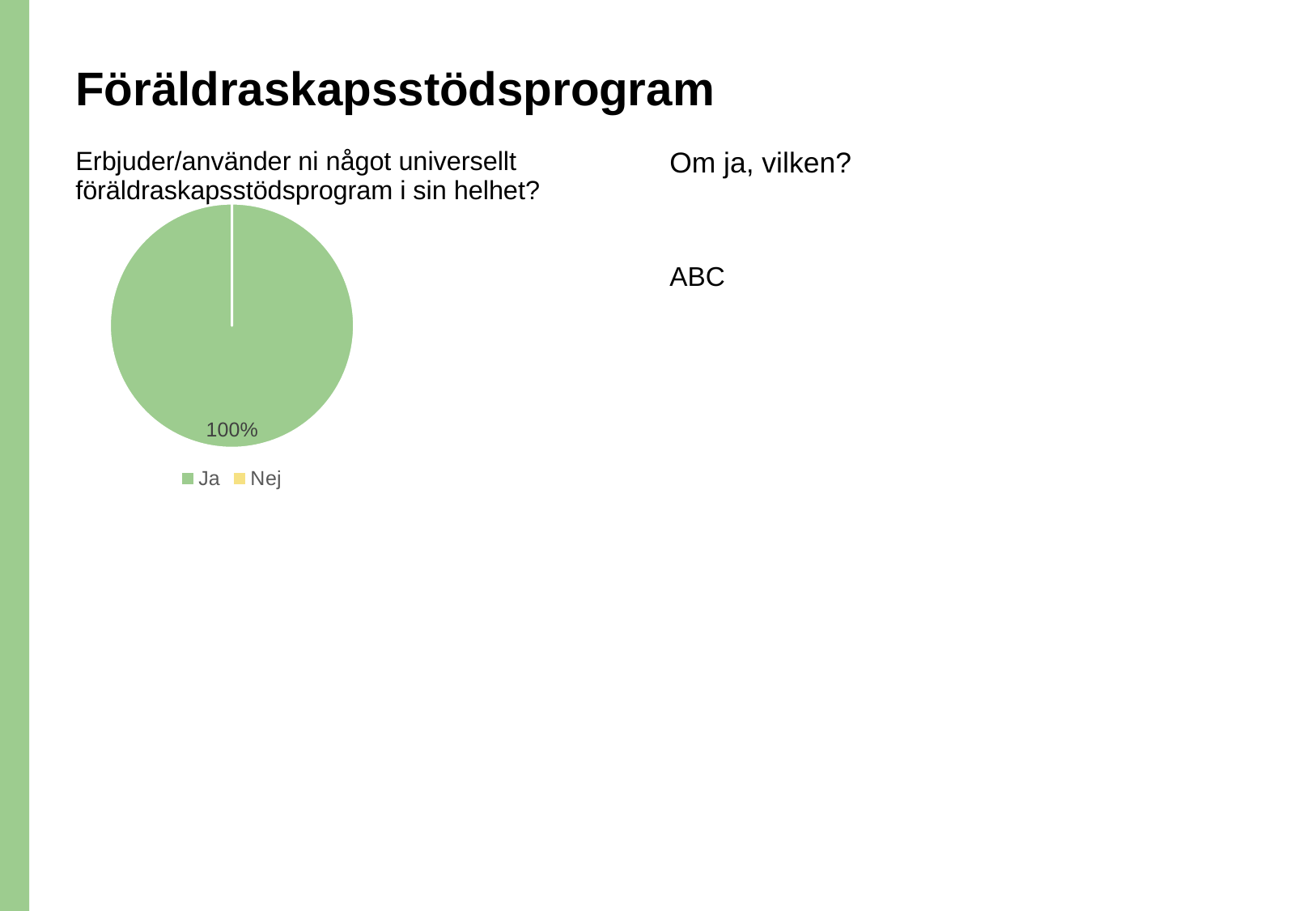
Which category has the largest share of the pie? Ja How many entries does the legend list? 2 Which is larger, the share for "Ja" or the share for "Nej"? Ja What colour is the "Ja" slice of the pie? green What share of the pie does "Ja" have? 100% What kind of chart is shown on the slide? pie chart What are the two legend entries of the pie chart? Ja, Nej What is the only data label printed on the pie chart? 100%